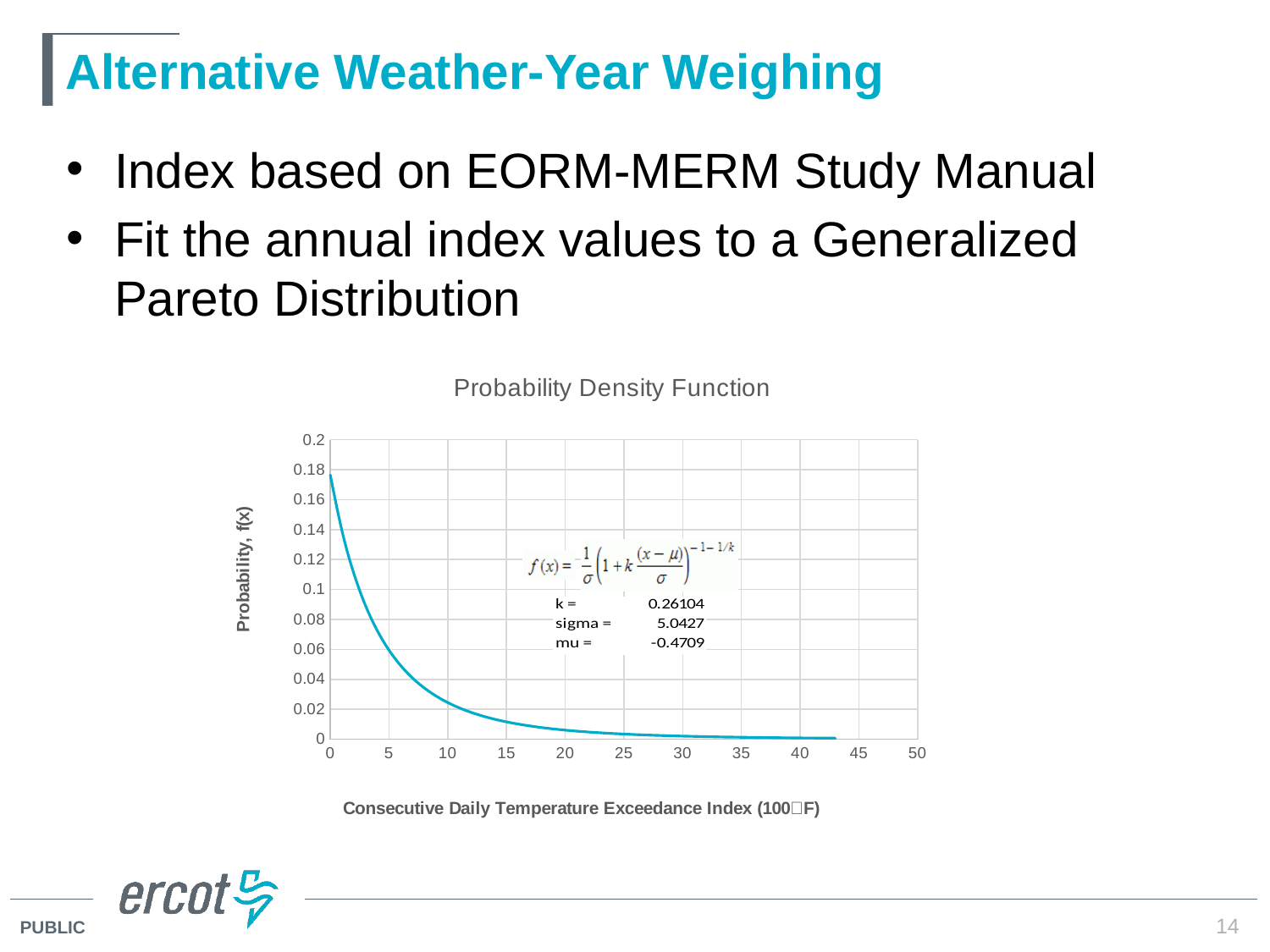
Is the value of the curve at an index of 5 greater or less than 0.1? less Which is larger, the value of the curve at an index of 5 or at an index of 15? index of 5 At which x-axis value is the probability density curve highest? 0 Do the values of the curve rise or fall as the index increases along the x axis? fall Is the value of the curve at an index of 20 greater or less than 0.02? less What is the label of the y axis of the chart? Probability, f(x) What value of k is printed on the chart for the fitted distribution? 0.26104 Is the value of the curve at an index of 0 greater or less than 0.16? greater What value of sigma is printed on the chart for the fitted distribution? 5.0427 What is the title of the chart? Probability Density Function What kind of chart is shown on the slide? line chart